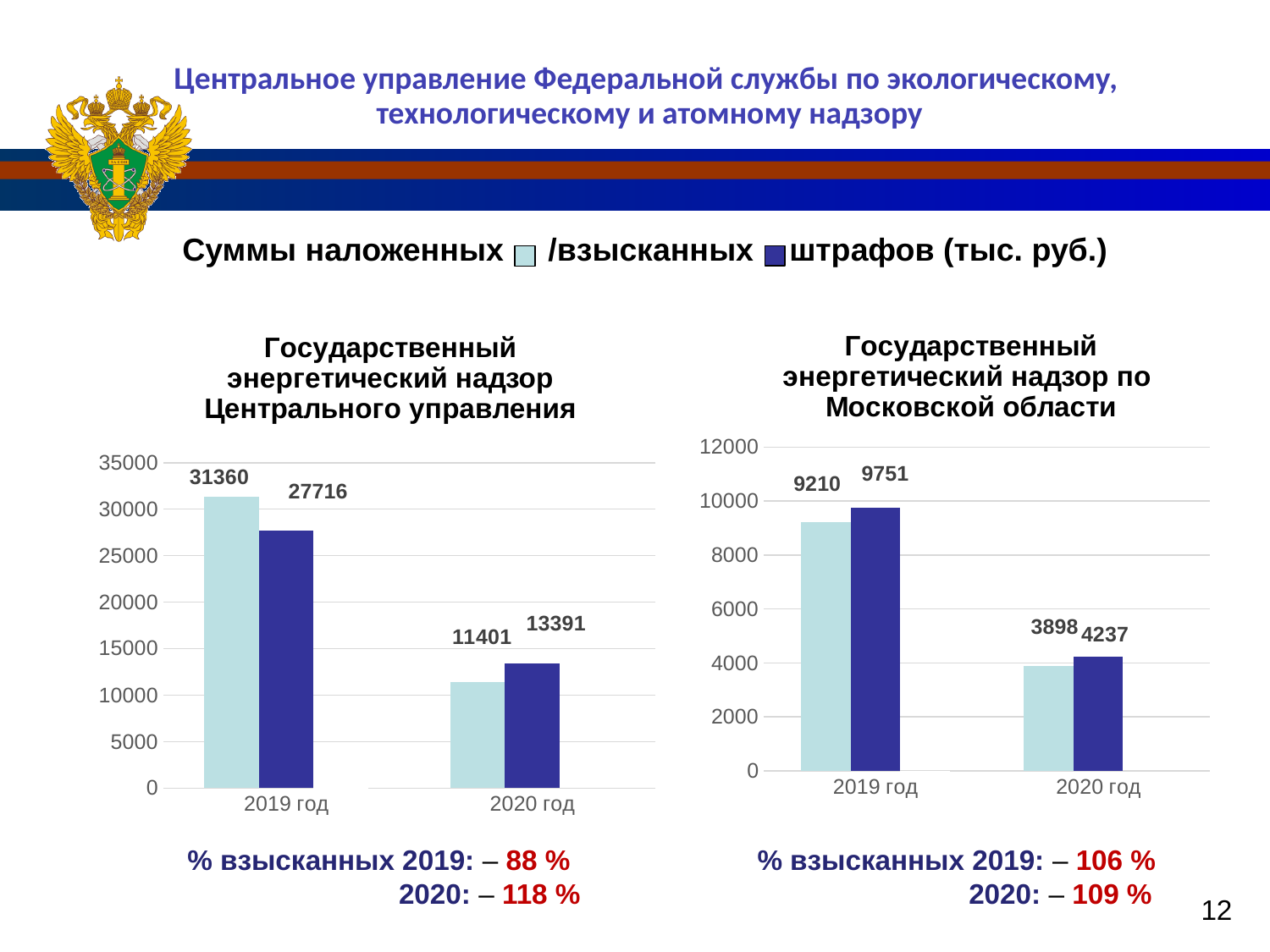
In the right chart (Государственный энергетический надзор по Московской области), what is the difference between the взысканных and наложенных values for 2020 год? 339 In the right chart (Государственный энергетический надзор по Московской области), what is the value of the light-blue bar (наложенных) for 2020 год? 3898 In the left chart (Государственный энергетический надзор Центрального управления), what is the value of the light-blue bar (наложенных) for 2019 год? 31360 In the left chart (Государственный энергетический надзор Центрального управления), which bar is the tallest? наложенных, 2019 год (31360) In the left chart (Государственный энергетический надзор Центрального управления), which is larger for 2020 год: наложенных or взысканных? взысканных How many series does the legend on the slide list? 2 In the left chart (Государственный энергетический надзор Центрального управления), what is the value of the dark-blue bar (взысканных) for 2020 год? 13391 In the right chart (Государственный энергетический надзор по Московской области), do the values fall or rise from 2019 год to 2020 год? fall In the right chart (Государственный энергетический надзор по Московской области), what is the value of the dark-blue bar (взысканных) for 2019 год? 9751 What type of chart is the right chart (Государственный энергетический надзор по Московской области)? bar chart In the right chart (Государственный энергетический надзор по Московской области), which bar is the lowest? наложенных, 2020 год (3898) In the left chart (Государственный энергетический надзор Центрального управления), what is the difference between the наложенных and взысканных values for 2019 год? 3644